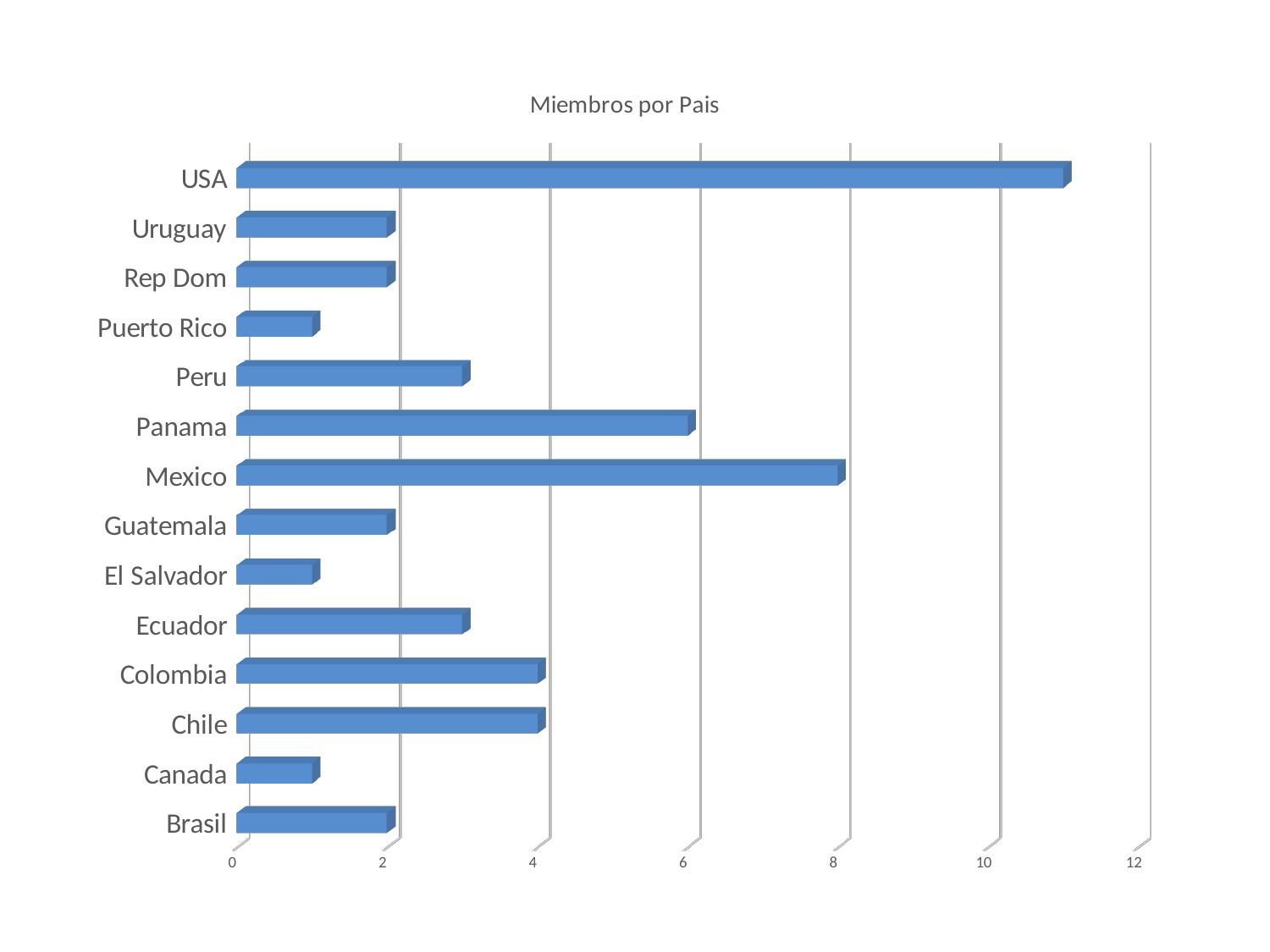
Is the value for Puerto Rico greater or less than 2? less What is the value for Mexico? 8 What is the value for Uruguay? 2 What is the value for Panama? 6 How many countries are shown in the chart? 14 Which country has the highest value in the chart? USA What is the value for Colombia? 4 What kind of chart is shown on the slide? bar chart What is the title of the chart? Miembros por Pais Is the value for USA greater or less than 10? greater Which is larger, the value for Chile or the value for Brasil? Chile What is the difference between the values for Mexico and Panama? 2